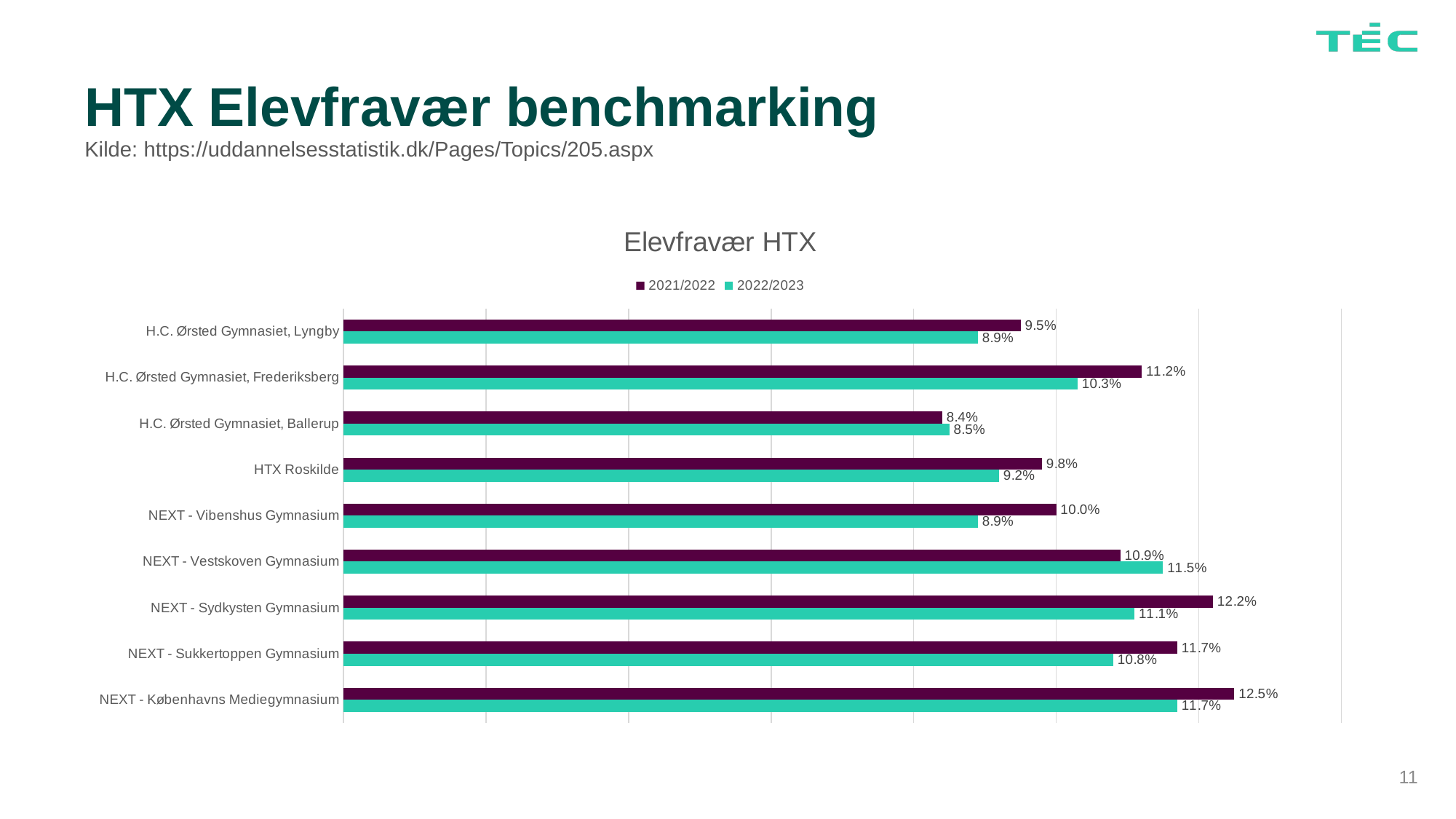
Which school has the lowest 2022/2023 value? H.C. Ørsted Gymnasiet, Ballerup For NEXT - Vestskoven Gymnasium, which is larger: the 2021/2022 value or the 2022/2023 value? 2022/2023 What is the difference between the 2021/2022 and 2022/2023 values for NEXT - Vibenshus Gymnasium? 1.1% What is the 2021/2022 value for NEXT - Sydkysten Gymnasium? 12.2% What is the title of the chart? Elevfravær HTX What is the difference between the 2021/2022 values for NEXT - Sukkertoppen Gymnasium and H.C. Ørsted Gymnasiet, Lyngby? 2.2% What type of chart is shown on the slide? Bar chart How many schools are shown in the chart? 9 How many series does the legend list? 2 What is the 2022/2023 value for HTX Roskilde? 9.2% What is the 2022/2023 value for H.C. Ørsted Gymnasiet, Frederiksberg? 10.3% Which school has the highest 2021/2022 value? NEXT - Københavns Mediegymnasium